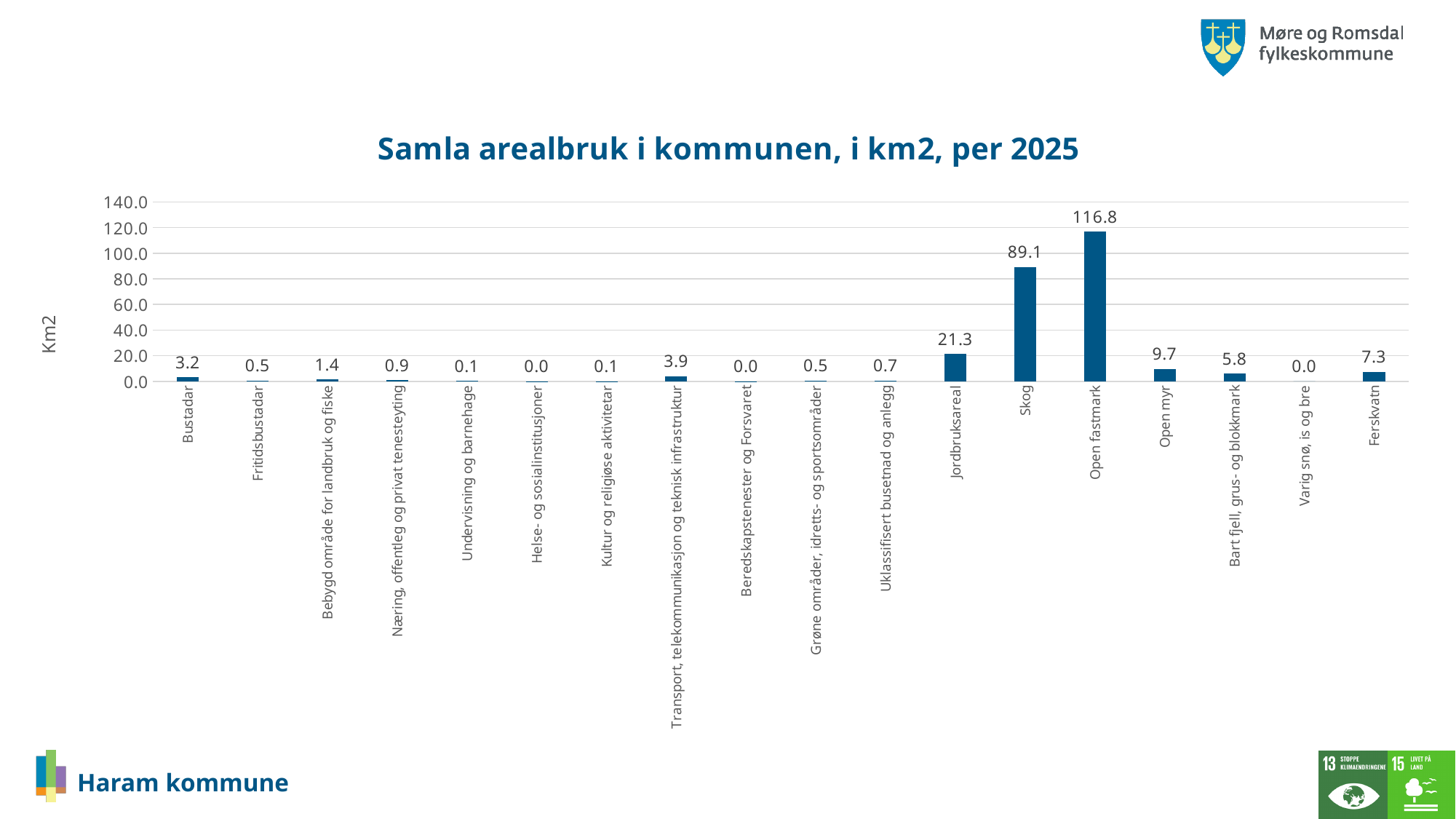
What is the value for Bustadar? 3.2 What kind of chart is shown? bar chart How many categories are shown on the x axis? 18 Which category has the highest value? Open fastmark What is the value for Ferskvatn? 7.3 What is the title of the chart? Samla arealbruk i kommunen, i km2, per 2025 What is the difference between Open fastmark and Skog? 27.7 Is the value for Skog greater or less than 100.0? less Which is larger, Jordbruksareal or Open myr? Jordbruksareal What is the difference between Open myr and Bart fjell, grus- og blokkmark? 3.9 What is the value for Jordbruksareal? 21.3 What is the value for Skog? 89.1